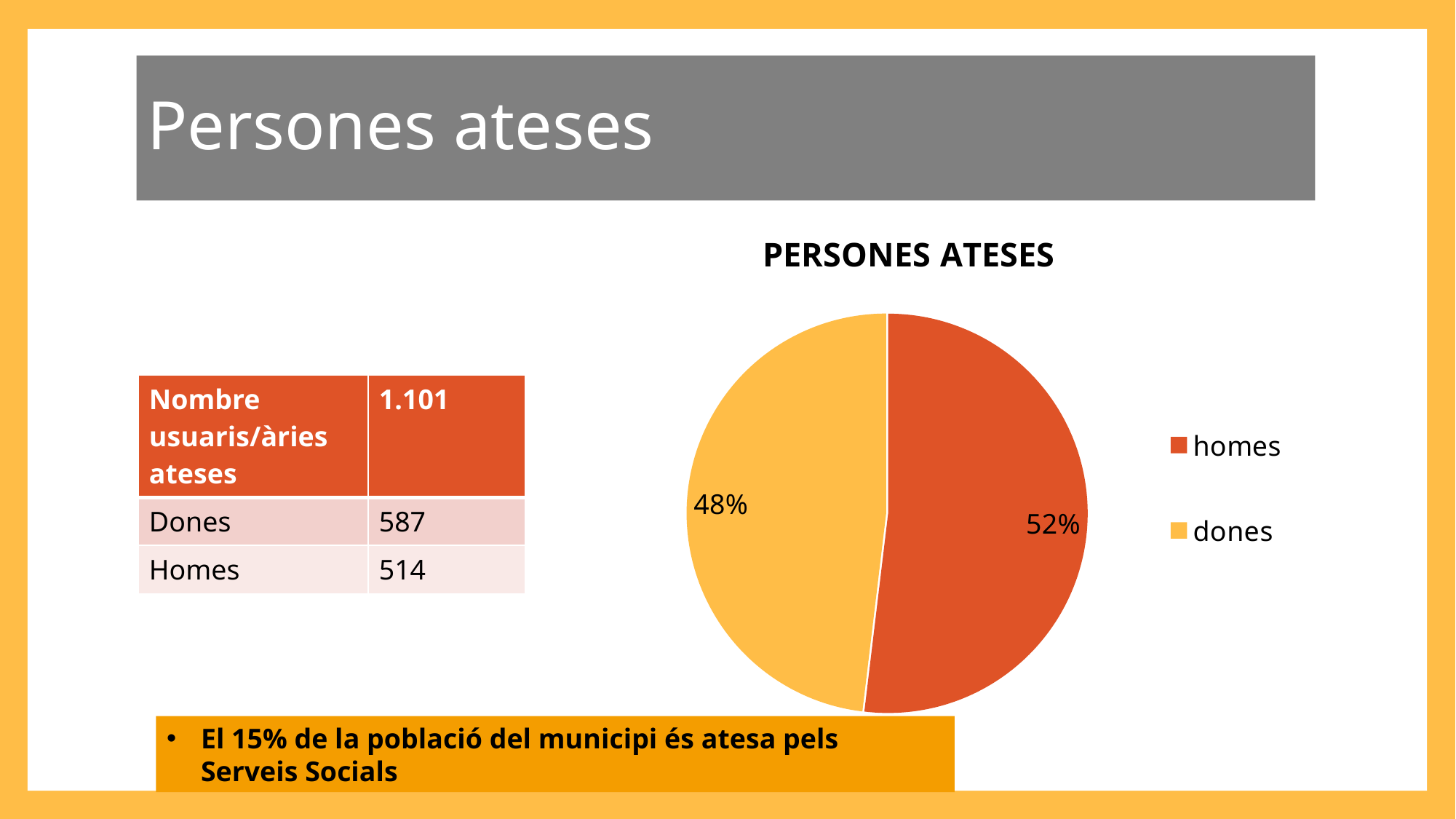
What percentage of the pie chart is labelled for dones? 48% What is the title of the chart? PERSONES ATESES How many slices does the pie chart have? 2 What kind of chart is shown on the slide? Pie chart Which slice is larger in the pie chart, homes or dones? homes Which slice of the pie chart is the smallest? dones What is the difference in percentage points between the homes slice and the dones slice? 4 percentage points Which colour represents dones in the pie chart? Yellow Which slice of the pie chart is the largest? homes What percentage of the pie chart is labelled for homes? 52% How many entries does the chart legend list? 2